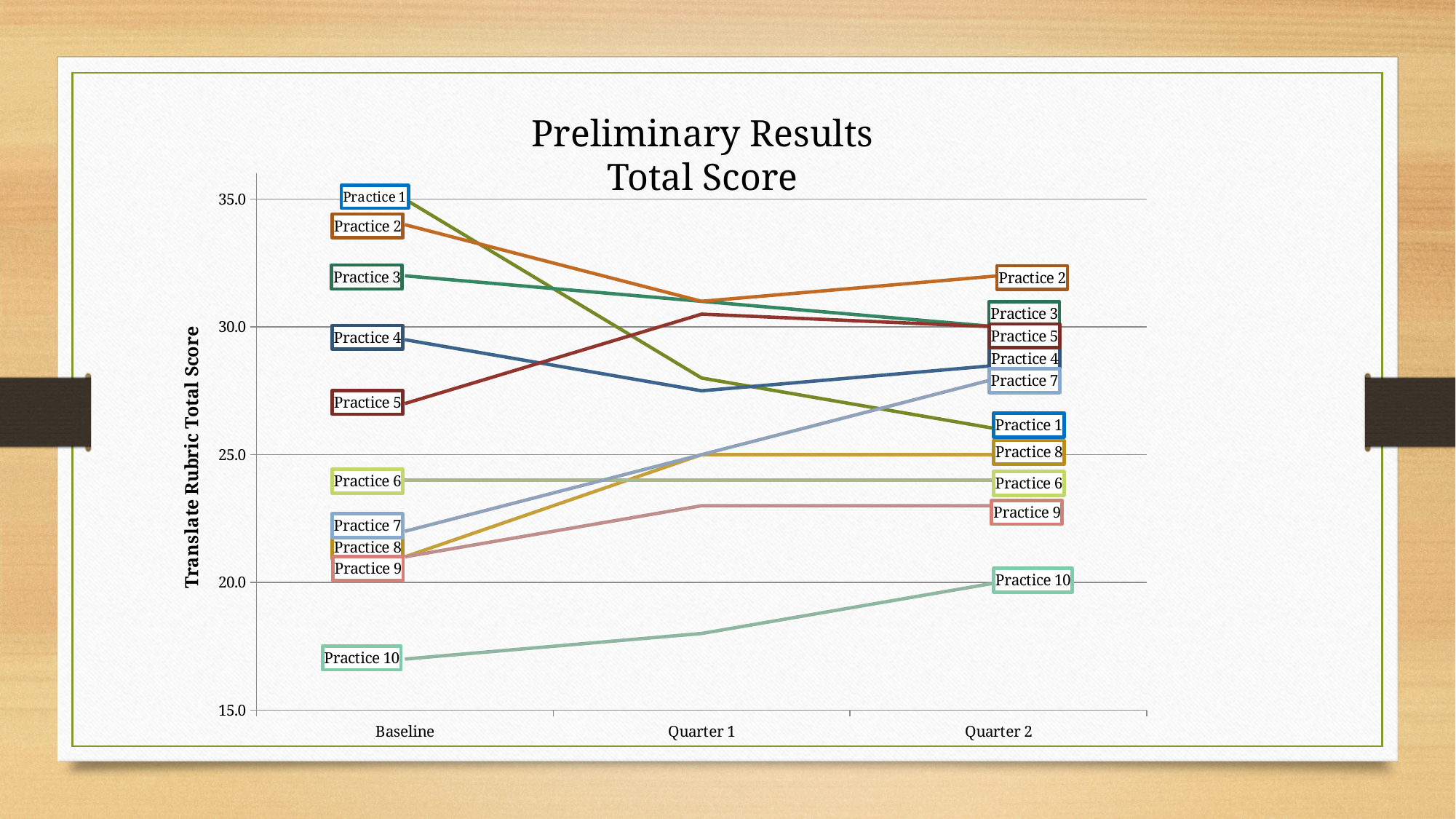
Which practice has the lowest total score at Quarter 2? Practice 10 What is the title of the y axis? Translate Rubric Total Score Does the total score for Practice 1 rise or fall from Baseline to Quarter 2? fall Which practice has the lowest total score at Baseline? Practice 10 Is the value for Practice 2 at Quarter 2 greater or less than 30.0? greater How many practices are plotted as separate lines? 10 How many time points are shown on the x axis? 3 Which practice has the highest total score at Baseline? Practice 1 What kind of chart is shown on the slide? line chart Is the value for Practice 6 at Baseline greater or less than 25.0? less Which practice has the highest total score at Quarter 2? Practice 2 Does the total score for Practice 10 rise or fall from Baseline to Quarter 2? rise